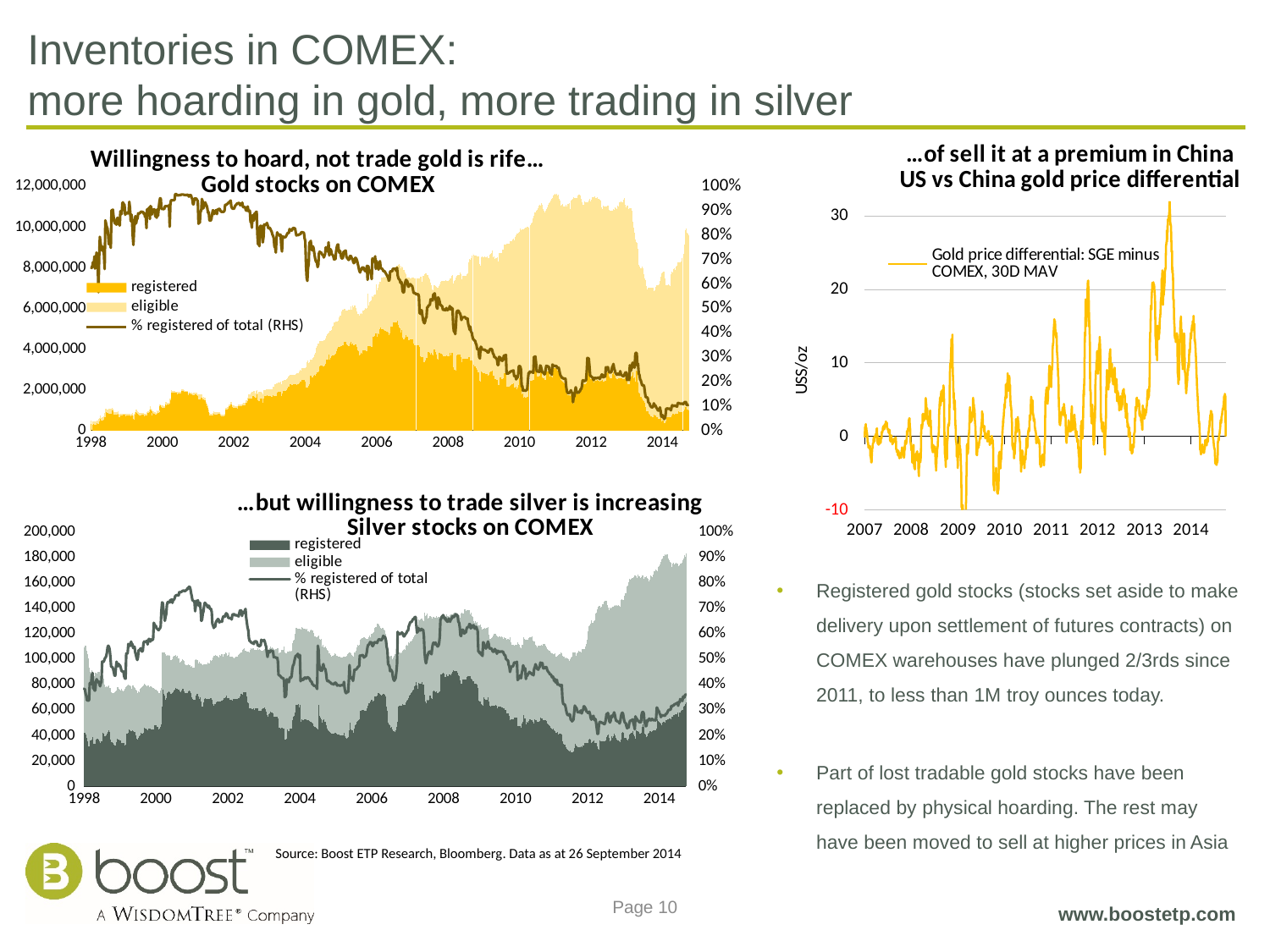
In the 'Gold stocks on COMEX' chart, does the '% registered of total (RHS)' line rise or fall overall from 1998 to 2014? fall What is the legend entry of the series in the 'US vs China gold price differential' chart? Gold price differential: SGE minus COMEX, 30D MAV What is the y-axis label of the 'US vs China gold price differential' chart? US$/oz How many series does the legend of the 'US vs China gold price differential' chart list? 1 In the 'Gold stocks on COMEX' chart, is the '% registered of total (RHS)' value in 2014 greater or less than 20%? less In the 'Gold stocks on COMEX' chart, is the '% registered of total (RHS)' value in 2000 greater or less than 80%? greater In the 'Silver stocks on COMEX' chart, is the '% registered of total (RHS)' value in 2014 greater or less than 50%? less In the 'Silver stocks on COMEX' chart, which series is shown in the darker shade: registered or eligible? registered How many series does the legend of the 'Gold stocks on COMEX' chart list? 3 What kind of chart is the 'US vs China gold price differential' chart on the right? line chart How many series does the legend of the 'Silver stocks on COMEX' chart list? 3